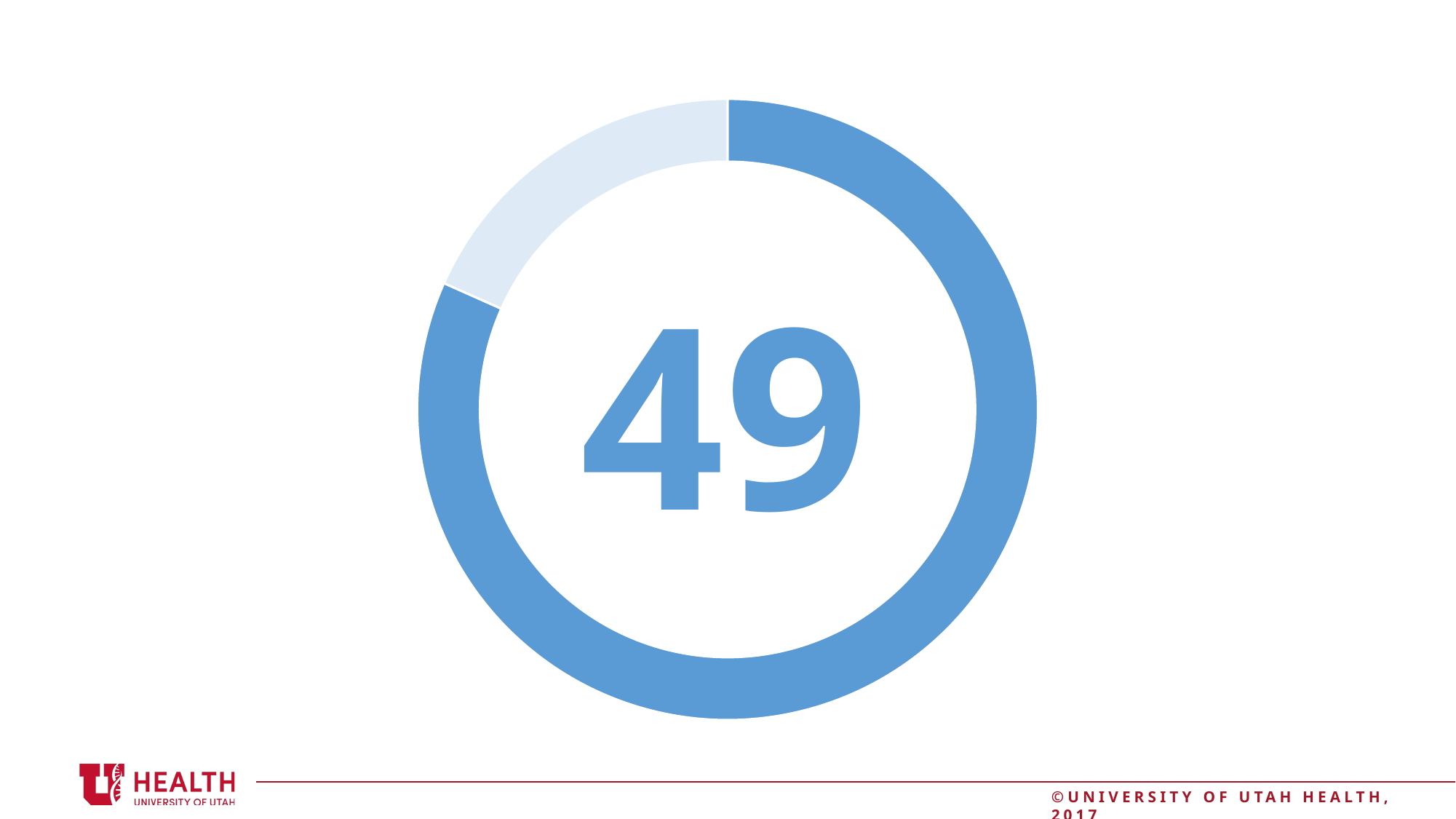
Does the doughnut chart have a legend? No Which segment of the doughnut chart is larger, the dark blue one or the light blue one? the dark blue one How many segments does the doughnut chart have? 2 What kind of chart is shown on the slide? doughnut chart What number is displayed in the centre of the doughnut chart? 49